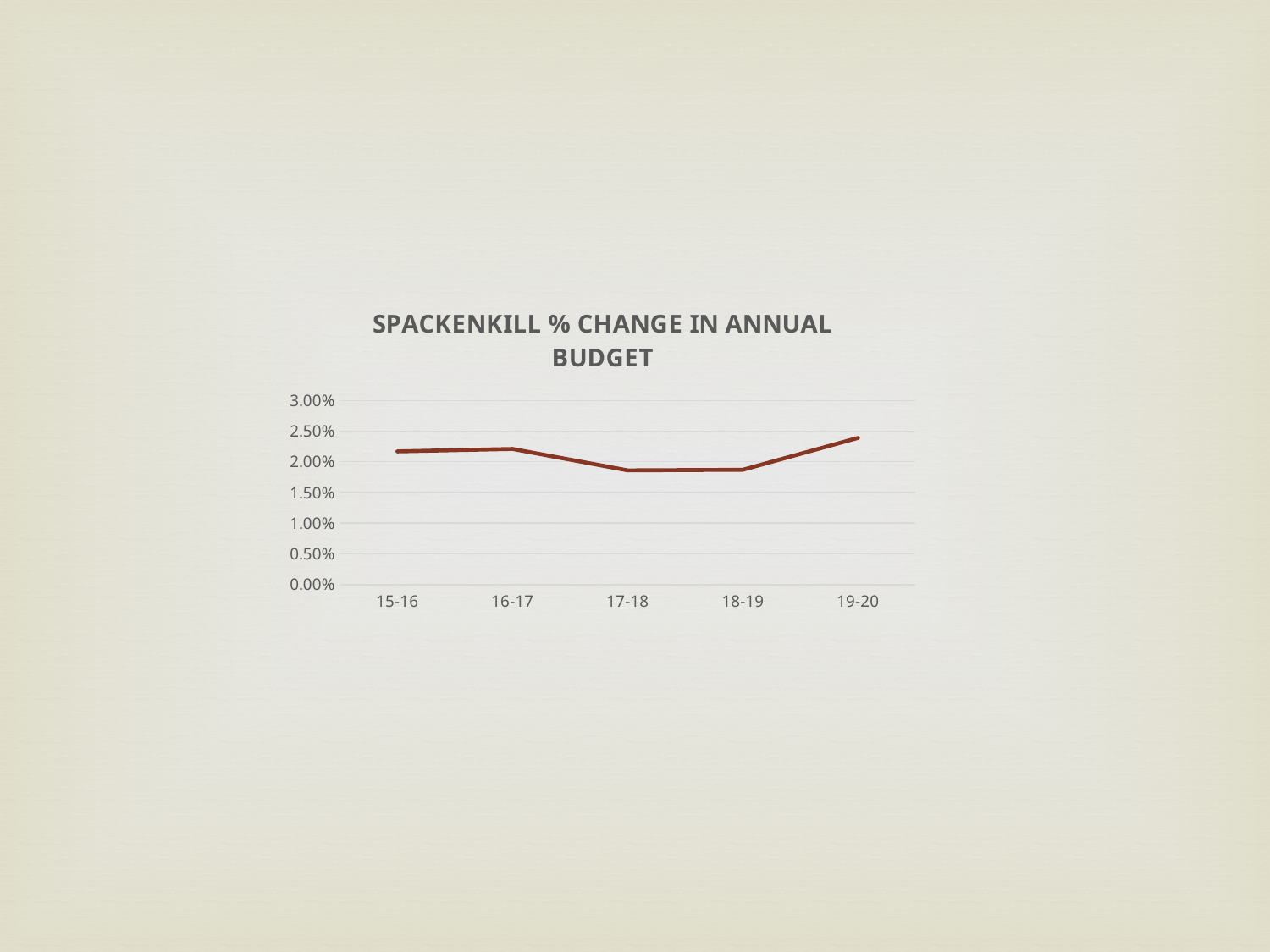
Is the value for 17-18 greater or less than 2.00%? less Does the line rise or fall from 18-19 to 19-20? rise How many school years are plotted on the x axis? 5 Is the value for 15-16 greater or less than 2.00%? greater Which year has the highest % change in annual budget? 19-20 Is the value for 18-19 greater or less than 1.50%? greater What is the title of the chart? SPACKENKILL % CHANGE IN ANNUAL BUDGET What kind of chart is shown on the slide? line chart Which is larger, the value for 19-20 or the value for 17-18? 19-20 Does the line rise or fall from 16-17 to 17-18? fall